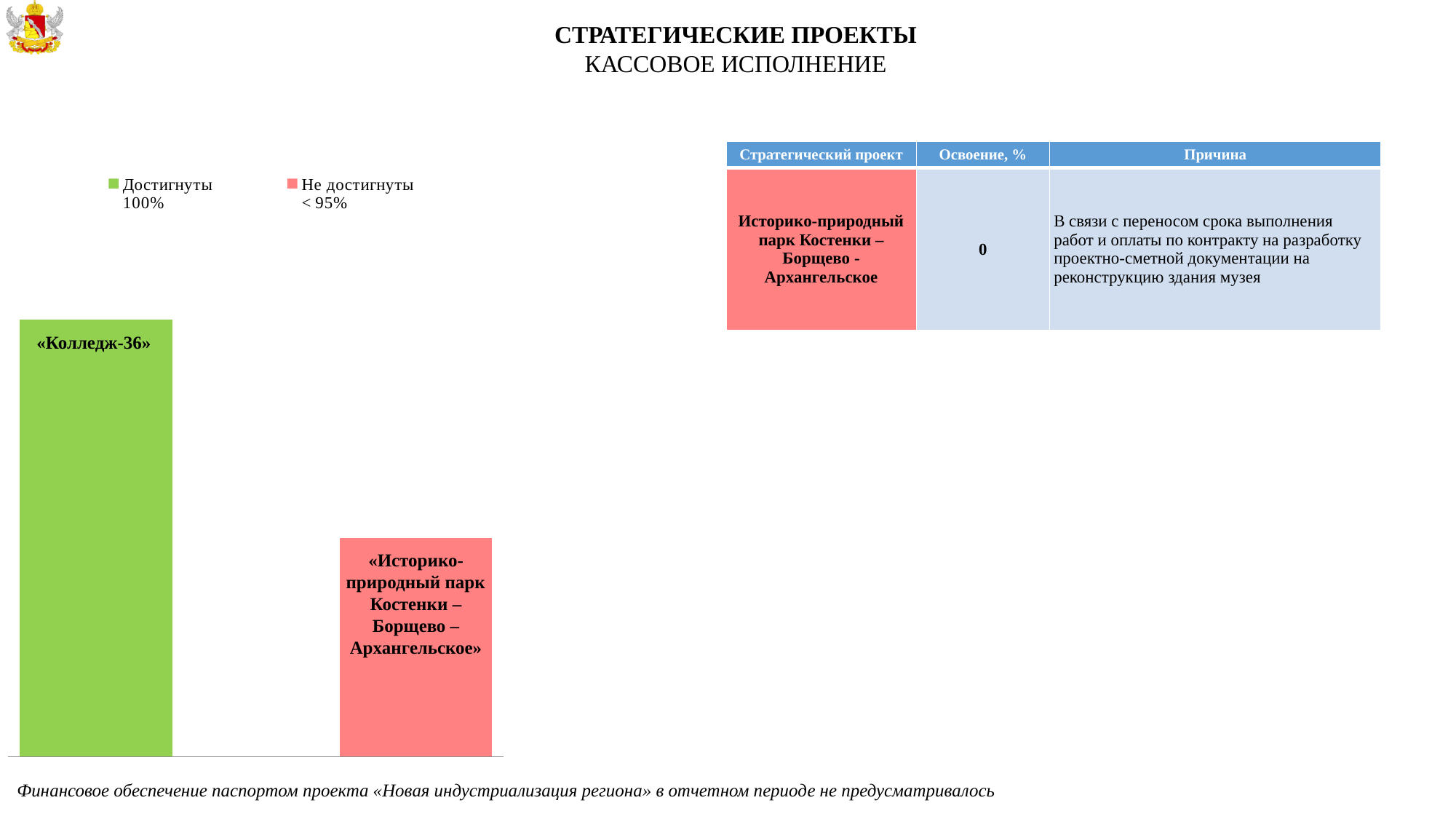
What kind of chart is shown on the left of the slide? bar chart How many bars does the chart on the left of the slide contain? 2 Which bar is taller: «Колледж-36» or «Историко-природный парк Костенки – Борщево – Архангельское»? «Колледж-36» How many entries does the legend of the chart list? 2 Which bar in the chart is the tallest? «Колледж-36» Which bar in the chart is the shortest? «Историко-природный парк Костенки – Борщево – Архангельское» What colour is the bar for «Колледж-36»? green Which legend entry is shown in red? Не достигнуты < 95%